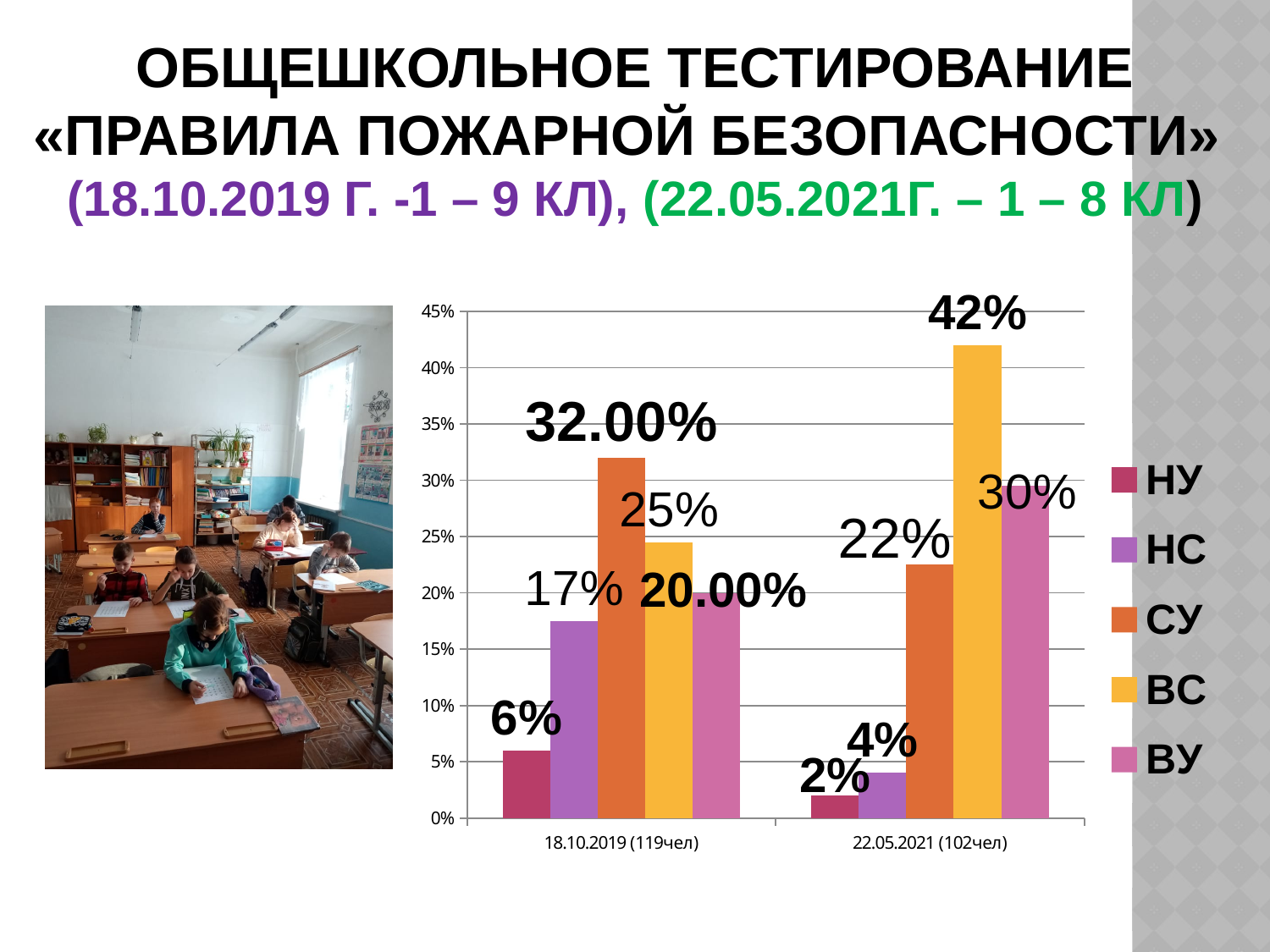
What is the value for ВУ in the 18.10.2019 (119чел) category? 20.00% What is the difference between the ВУ values for 22.05.2021 (102чел) and 18.10.2019 (119чел)? 10% What is the value for НУ in the 22.05.2021 (102чел) category? 2% What is the value for СУ in the 18.10.2019 (119чел) category? 32.00% Which series has the lowest value in the 18.10.2019 (119чел) category? НУ What colour are the ВС bars? Yellow How many series does the legend list? 5 Which is larger: the НС value for 18.10.2019 (119чел) or the НС value for 22.05.2021 (102чел)? 18.10.2019 (119чел) What is the value for ВС in the 22.05.2021 (102чел) category? 42% Which series has the highest value in the 22.05.2021 (102чел) category? ВС What kind of chart is shown on the slide? Bar chart How many categories are shown on the x axis? 2